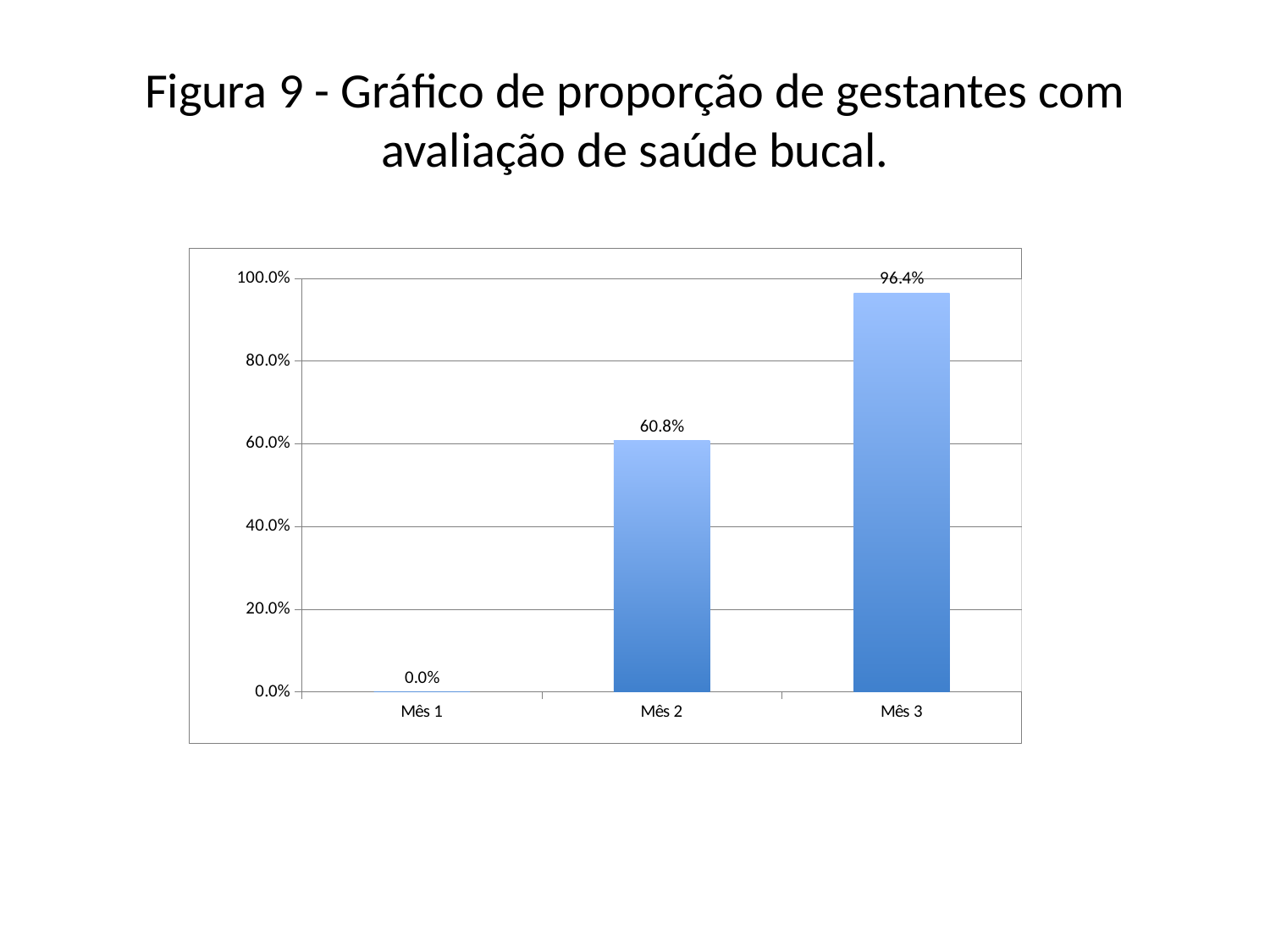
Is the value for Mês 3 greater or less than 80.0%? greater What is the value for Mês 2? 60.8% What is the difference between the values for Mês 3 and Mês 2? 35.6% Which month has the lowest value? Mês 1 Which month has the highest value? Mês 3 Which is larger, the value for Mês 2 or the value for Mês 3? Mês 3 How many categories are shown on the x axis? 3 What is the value for Mês 3? 96.4% Is the value for Mês 2 greater or less than 80.0%? less What is the value for Mês 1? 0.0% What kind of chart is shown on the slide? Bar chart Do the values rise or fall from Mês 1 to Mês 3? Rise